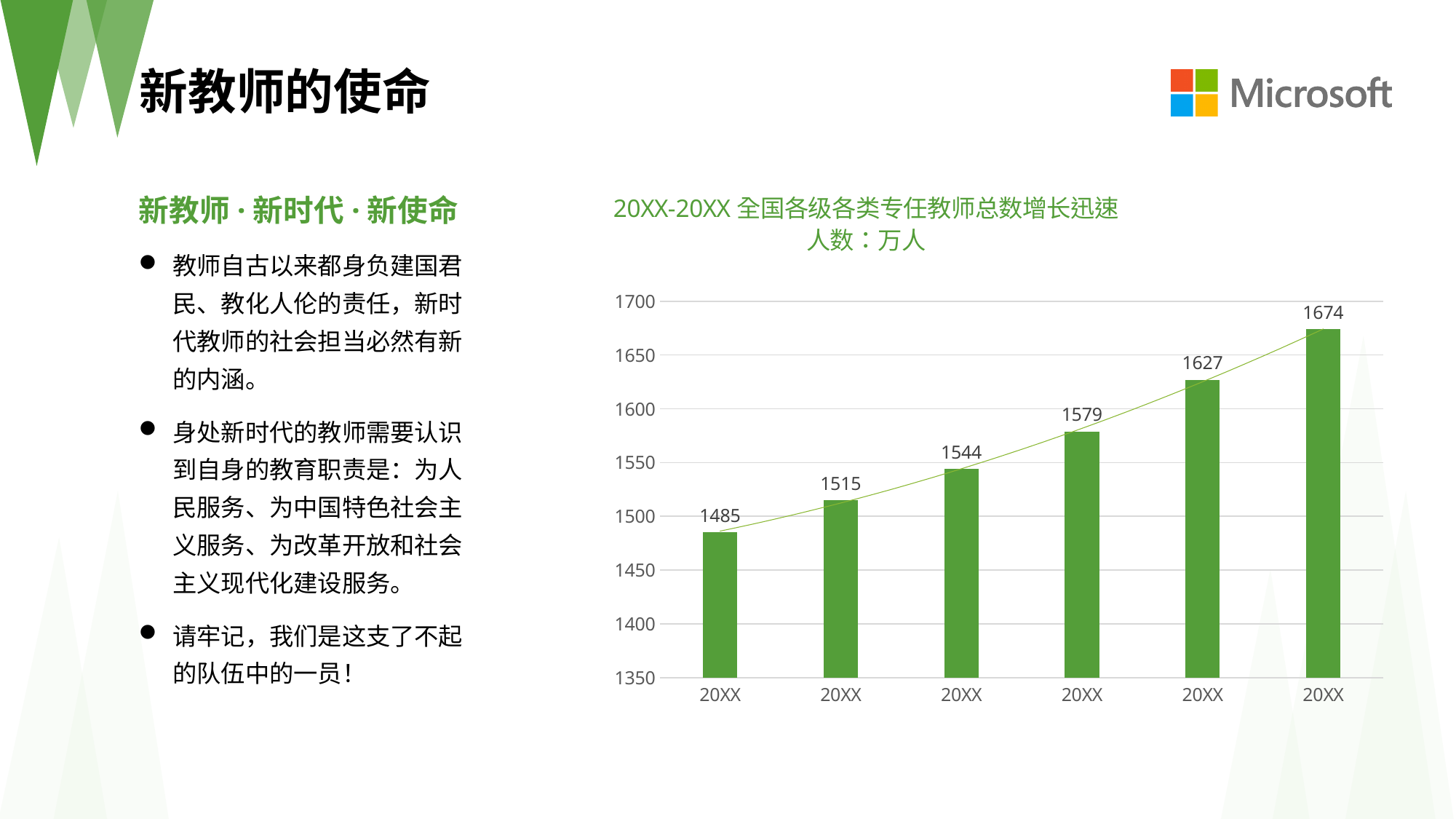
What is the value of the leftmost bar in the chart? 1485 What is the difference between the fourth bar (1579) and the second bar (1515)? 64 What kind of chart is shown on the slide? bar chart What is the value of the third bar from the left? 1544 What is the lowest value shown in the chart? 1485 How many bars are in the chart? 6 What is the value of the rightmost bar in the chart? 1674 What is the value of the fifth bar from the left? 1627 Do the values rise or fall from left to right along the x axis? rise Is the value of the fourth bar from the left greater or less than 1550? greater Which bar has the highest value, the leftmost or the rightmost? the rightmost What is the difference between the rightmost bar (1674) and the leftmost bar (1485)? 189